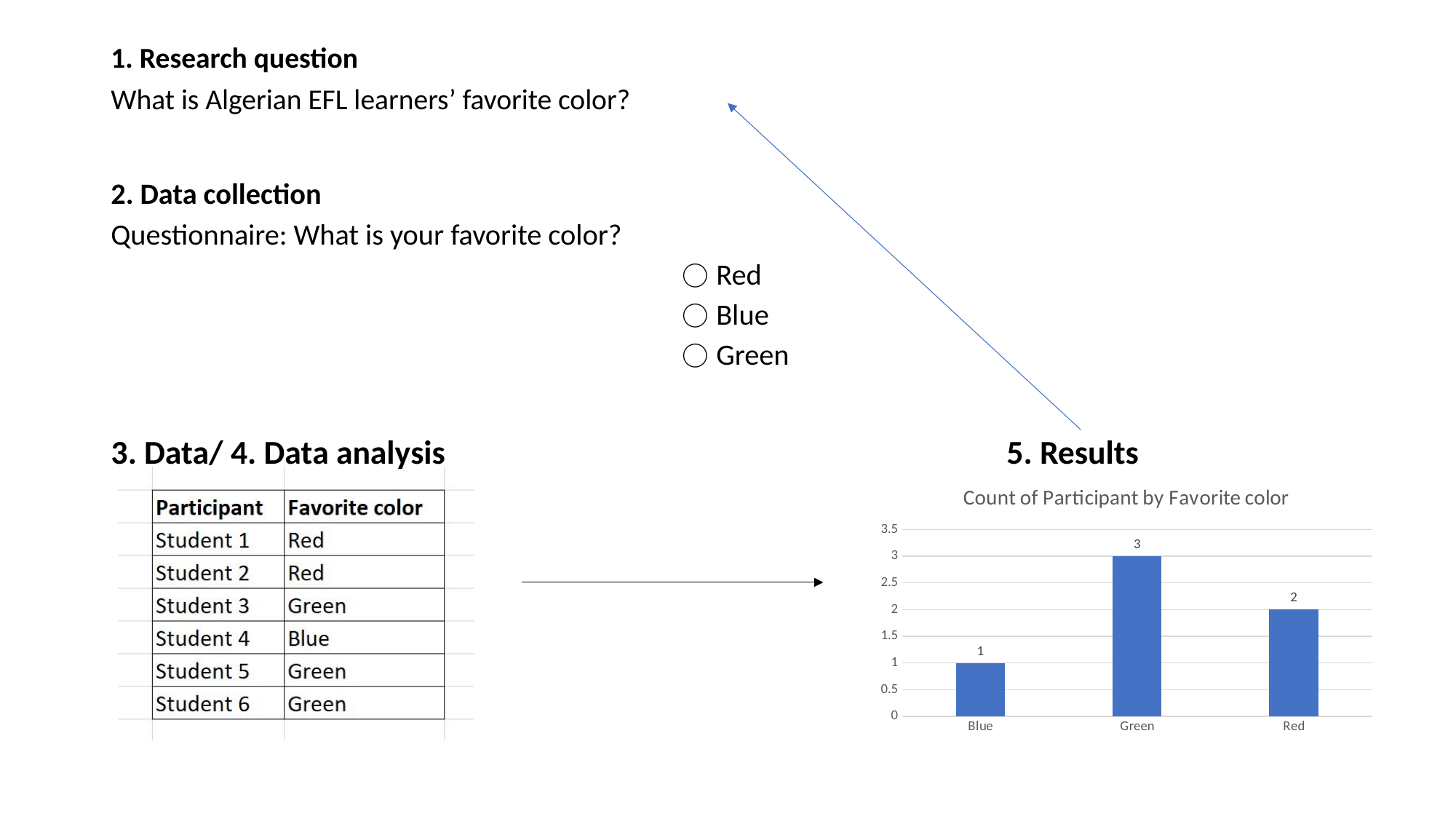
What is the count for Green in the chart? 3 Is the value for Green greater or less than 2.5? greater What is the count for Red in the chart? 2 Which color has the highest count in the chart? Green What is the title of the chart? Count of Participant by Favorite color What is the total of the counts for Blue, Green and Red? 6 How many categories are shown on the x axis of the chart? 3 What is the count for Blue in the chart? 1 Which color has the lowest count in the chart? Blue Which has a larger count, Red or Blue? Red What is the difference between the counts for Green and Red? 1 What kind of chart is shown on the slide? bar chart